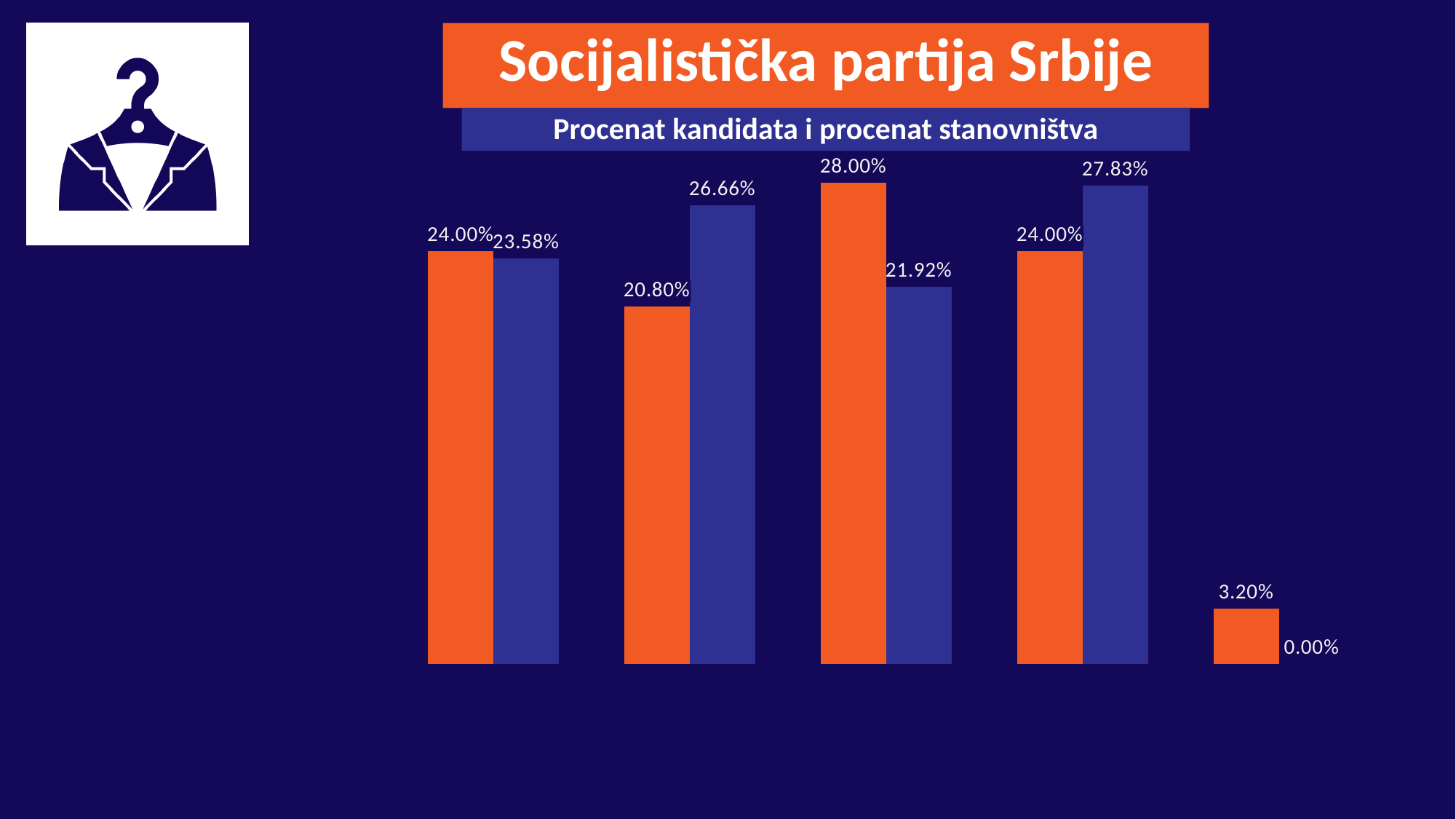
What is the difference between the blue and orange bars in the second group from the left? 5.86% Which group has the highest orange bar? the third group (28.00%) In the fourth group from the left, which bar is larger, the orange or the blue one? the blue one (27.83%) What is the value of the orange bar in the third group from the left? 28.00% How many groups of bars are plotted in the chart? 5 What is the title shown above the chart? Socijalistička partija Srbije What is the difference between the orange and blue bars in the third group from the left? 6.08% Which group has the lowest orange bar? the fifth (rightmost) group (3.20%) What kind of chart is shown on the slide? bar chart What is the value of the blue bar in the second group from the left? 26.66% What is the value of the blue bar in the fifth (rightmost) group? 0.00% What is the value of the orange bar in the first group from the left? 24.00%